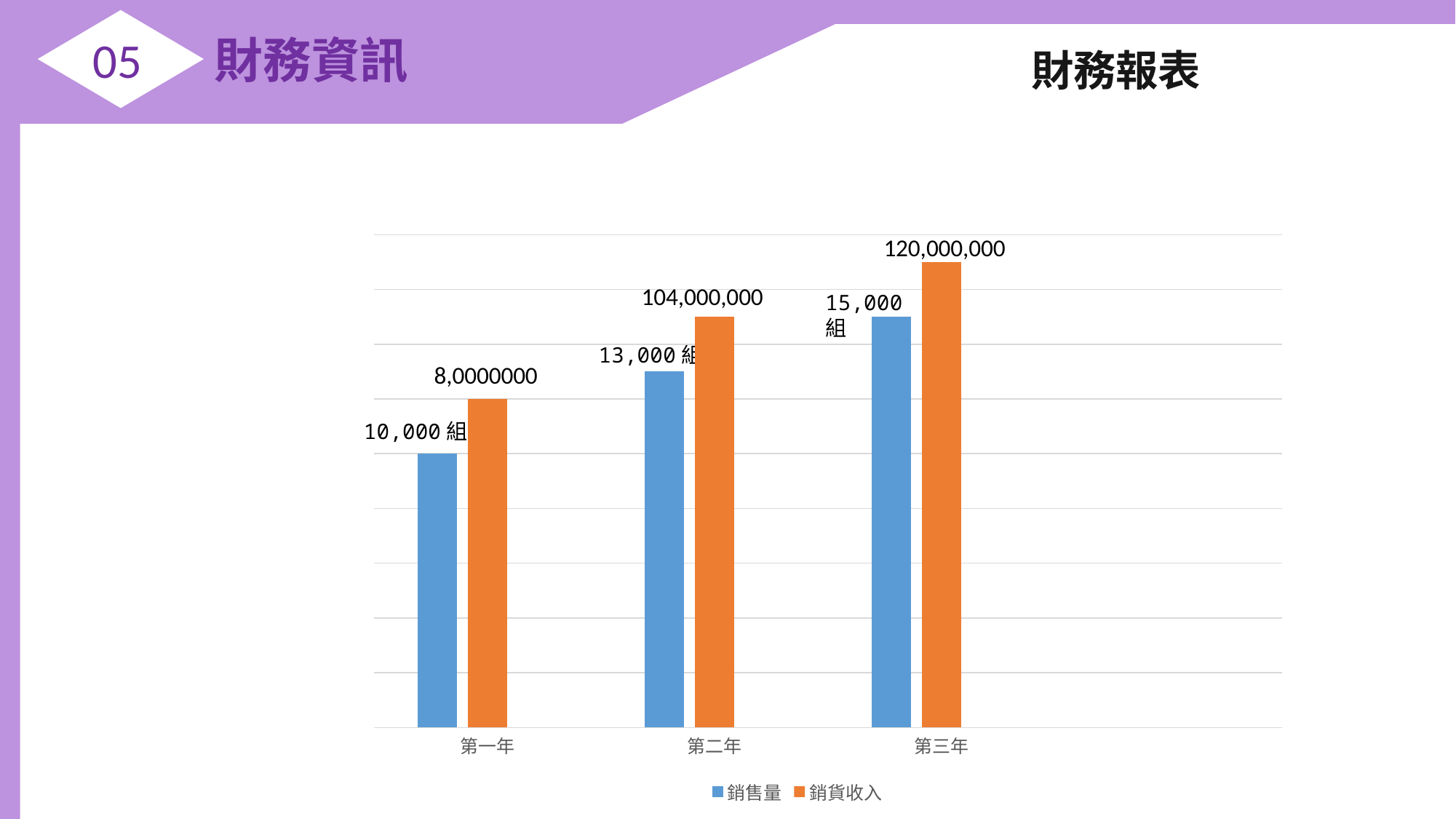
Do the 銷售量 values rise or fall from 第一年 to 第三年? rise What is the value of 銷售量 for 第二年? 13,000 組 How many series does the legend list? 2 What is the difference in 銷售量 between 第二年 and 第一年? 3,000 組 Which year has the lowest 銷售量? 第一年 Which year has the highest 銷貨收入? 第三年 What type of chart is shown on the slide? bar chart What is the value of 銷售量 for 第一年? 10,000 組 What is the value of 銷貨收入 for 第二年? 104,000,000 What is the value of 銷貨收入 for 第三年? 120,000,000 What is the value of 銷售量 for 第三年? 15,000 組 How many categories are shown on the x axis? 3